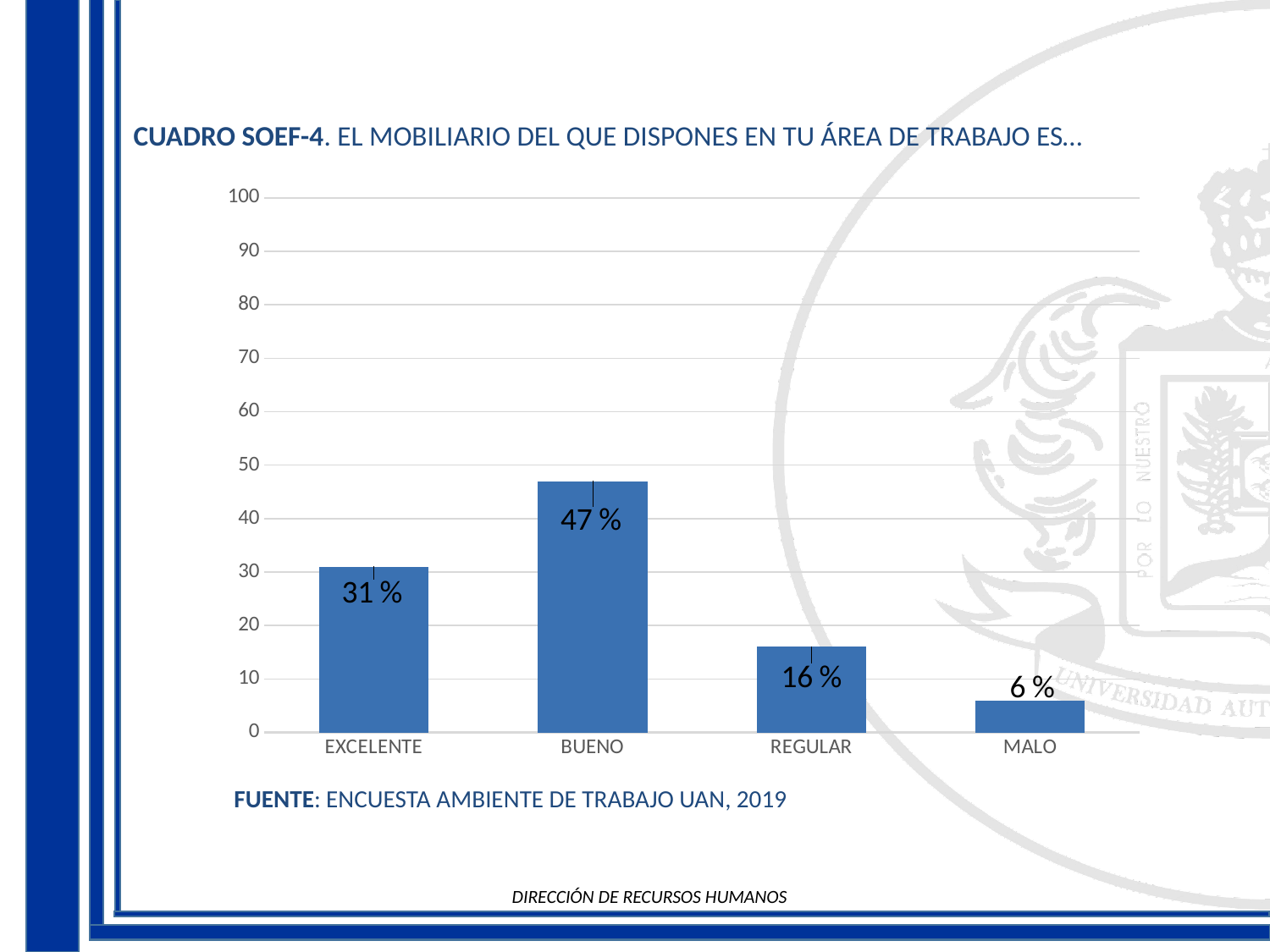
Which category has the highest value? BUENO What is the value for MALO? 6 % Which is larger, the value for REGULAR or the value for MALO? REGULAR How many categories are shown on the x axis? 4 What kind of chart is shown on the slide? bar chart Is the value for BUENO greater or less than 50? less What is the value for EXCELENTE? 31 % What is the difference between the values for BUENO and EXCELENTE? 16 % Which category has the lowest value? MALO What source is cited below the chart? ENCUESTA AMBIENTE DE TRABAJO UAN, 2019 What is the value for REGULAR? 16 % What is the value for BUENO? 47 %